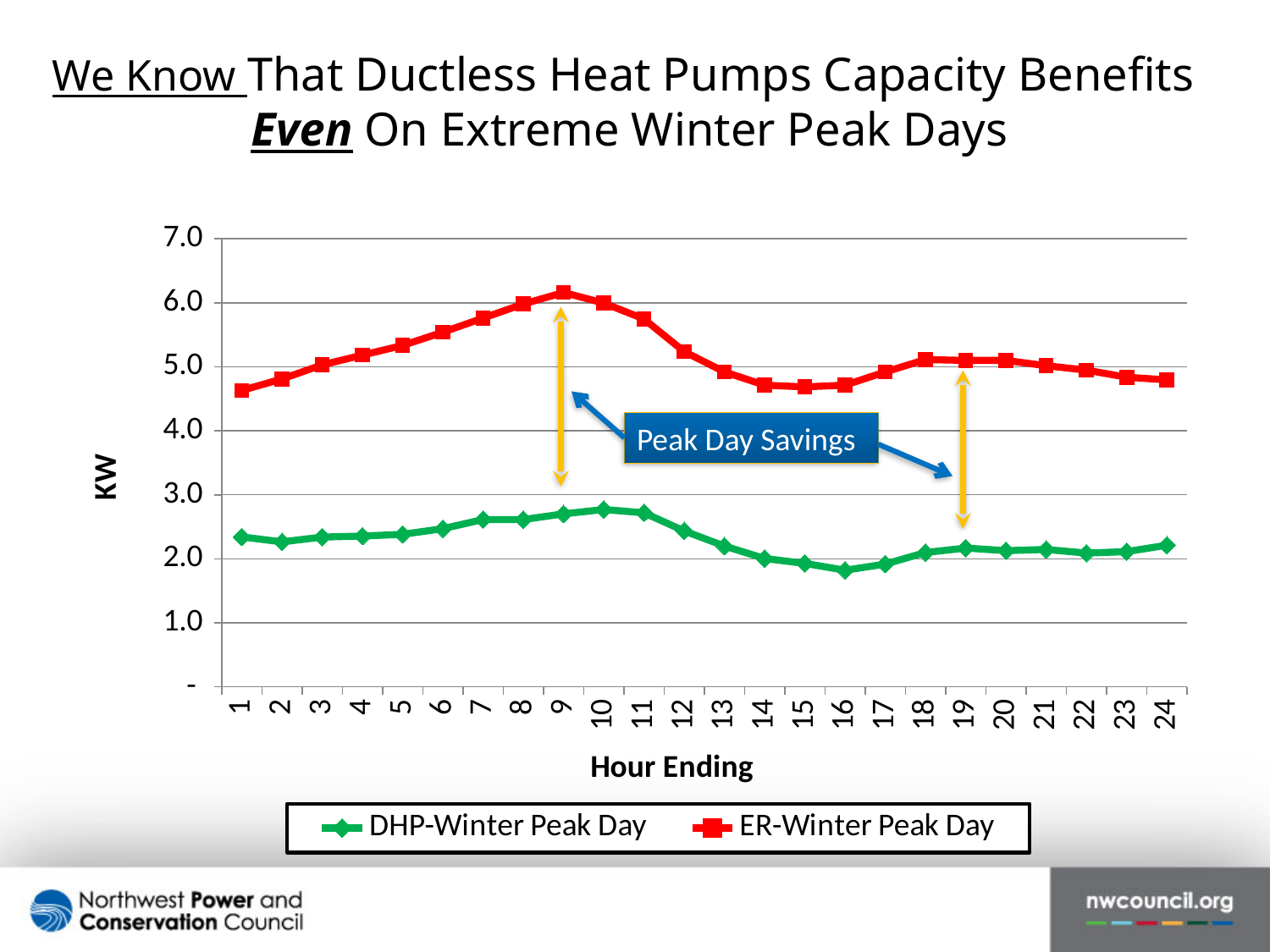
Does the ER-Winter Peak Day series rise or fall from hour ending 1 to hour ending 9? rise How many series does the legend list? 2 At which hour ending does the DHP-Winter Peak Day series reach its lowest value? 16 Is the value for ER-Winter Peak Day at hour ending 1 greater or less than 5.0? less What is the label on the y axis? KW Which series has the larger value at hour ending 9, DHP-Winter Peak Day or ER-Winter Peak Day? ER-Winter Peak Day What kind of chart is shown on the slide? line chart Is the value for DHP-Winter Peak Day at hour ending 16 greater or less than 2.0? less At which hour ending does the ER-Winter Peak Day series reach its highest value? 9 How many hours are plotted along the x axis? 24 What text appears in the blue callout box between the two lines? Peak Day Savings Is the value for ER-Winter Peak Day at hour ending 9 greater or less than 5.0? greater